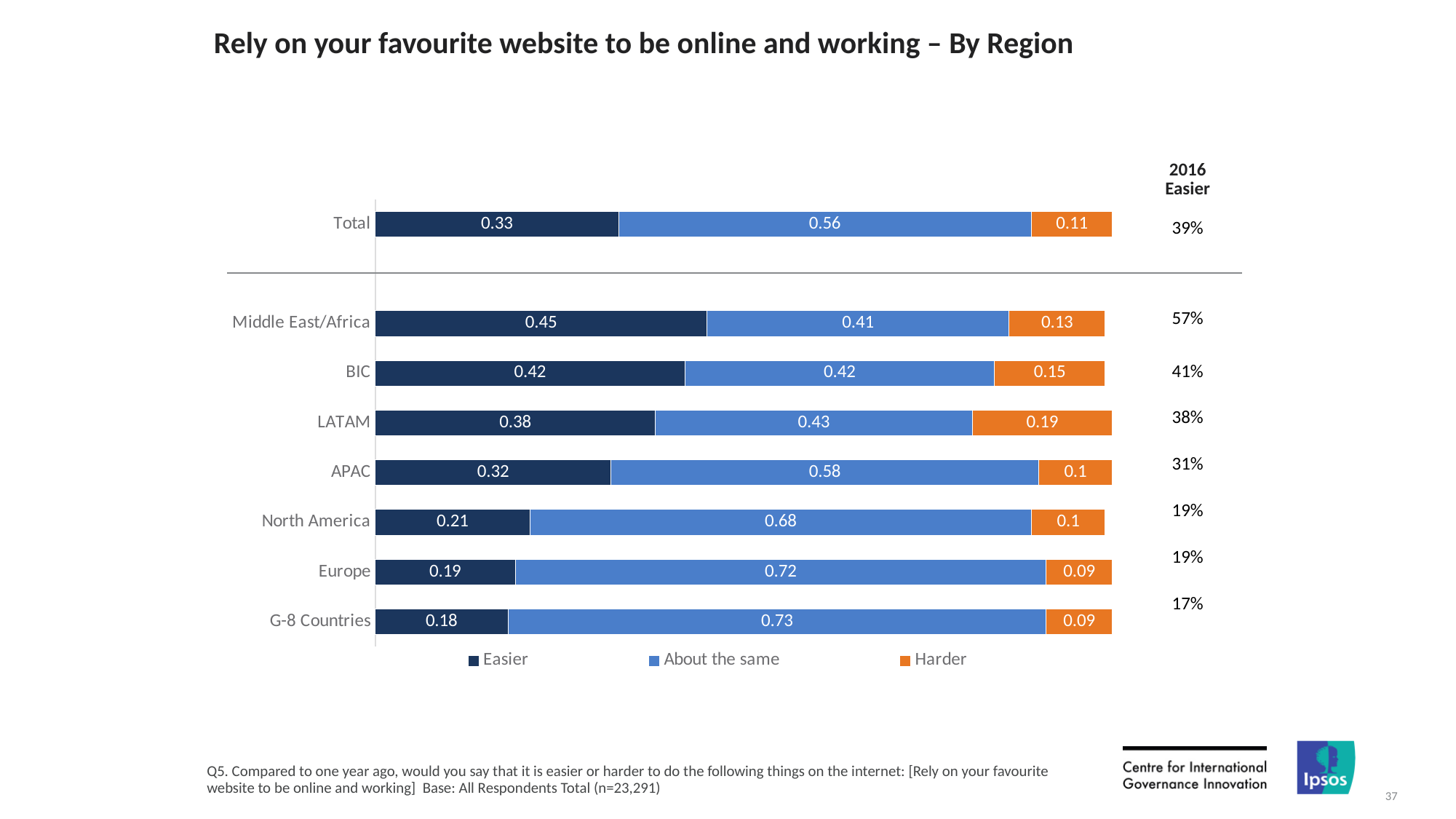
Which region has the highest 'Harder' value? LATAM Which region has the highest 'Easier' value? Middle East/Africa How many series does the legend list? 3 How many regions are shown in the chart, including Total? 8 What kind of chart is shown on the slide? Stacked bar chart What is the 2016 Easier percentage shown for North America? 19% Which region has the lowest 'Easier' value? G-8 Countries Which is larger, the 'Easier' value for BIC or for APAC? BIC What is the difference between the 'About the same' values for G-8 Countries and Total? 0.17 What is the 'About the same' value for Europe? 0.72 What is the 'Harder' value for LATAM? 0.19 What is the 'Easier' value for Middle East/Africa? 0.45